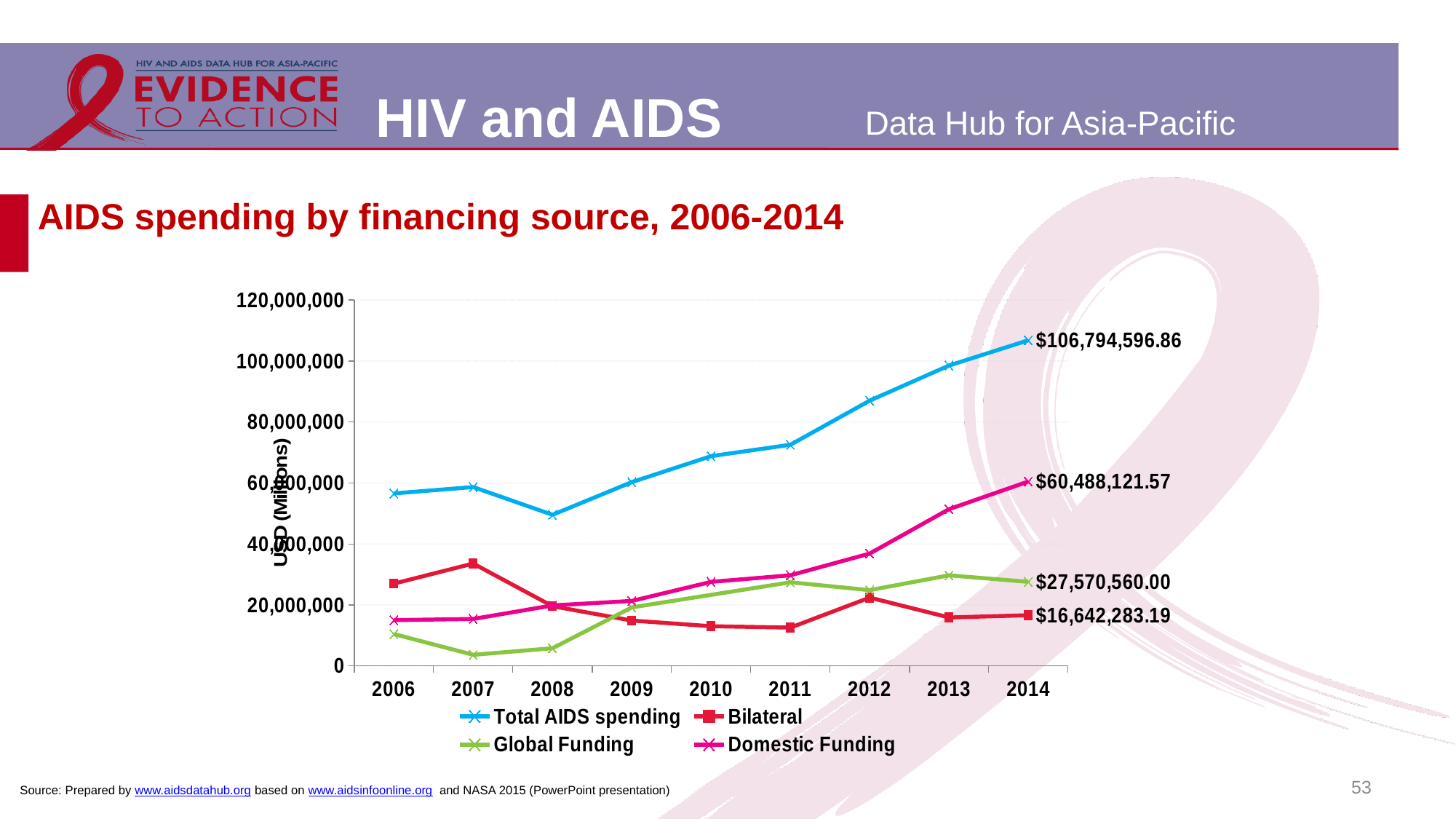
What is the difference between Total AIDS spending and Domestic Funding in 2014? $46,306,475.29 How many years are shown on the x axis? 9 What is the value for Domestic Funding in 2014? $60,488,121.57 What is the value for Total AIDS spending in 2014? $106,794,596.86 What type of chart is shown on the slide? Line chart Is the value for Total AIDS spending in 2008 greater or less than 60,000,000? less What is the label on the y axis? USD (Millions) Which series has the lowest value in 2014? Bilateral What is the value for Global Funding in 2014? $27,570,560.00 How many series does the legend list? 4 Does Domestic Funding rise or fall from 2006 to 2014? Rise What is the value for Bilateral in 2014? $16,642,283.19